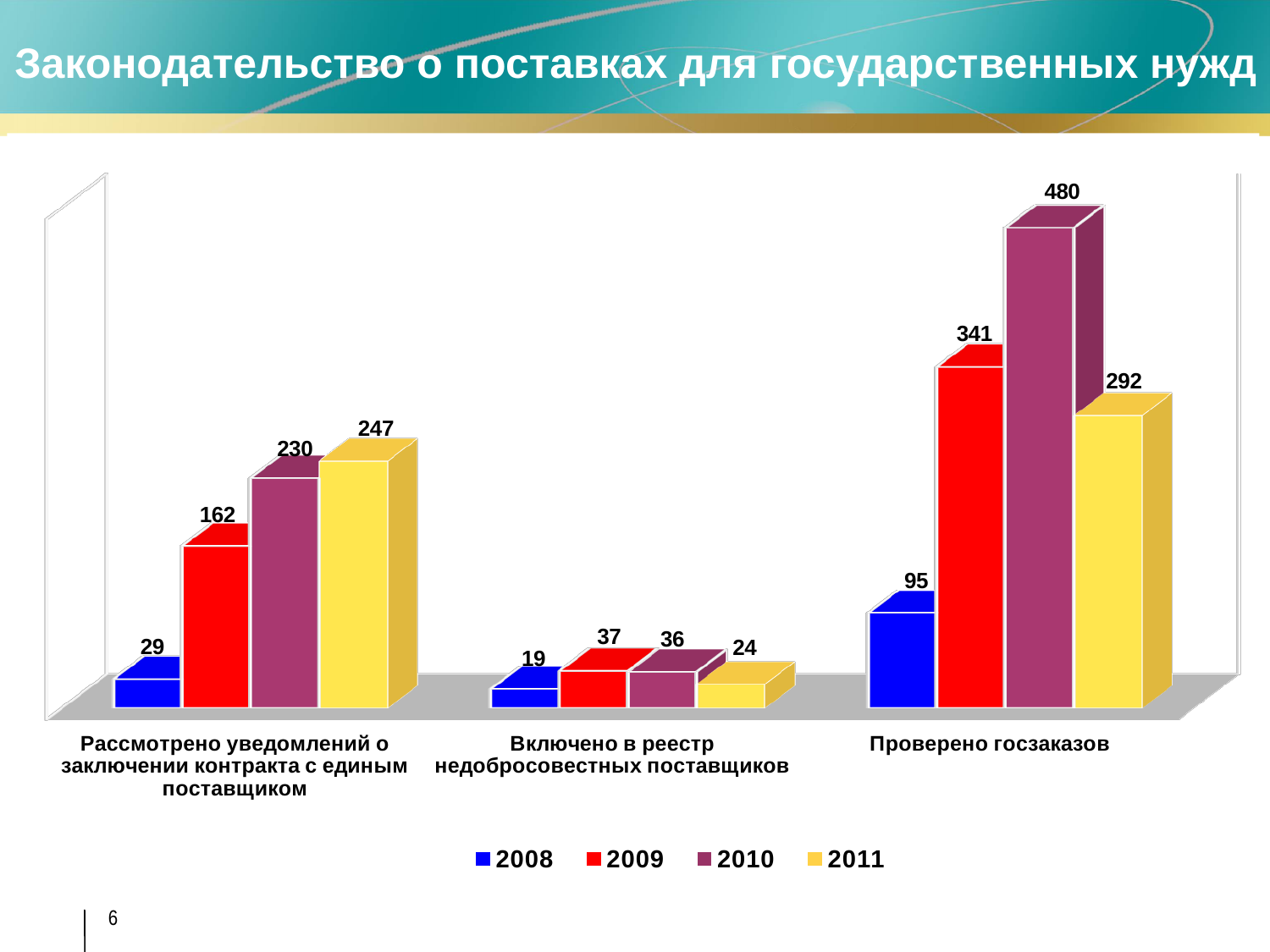
Which colour represents the 2011 series in the legend? yellow What is the value for 2008 in the category "Рассмотрено уведомлений о заключении контракта с единым поставщиком"? 29 Which year has the highest value in the category "Проверено госзаказов"? 2010 How many series does the legend list? 4 What is the value for 2011 in the category "Включено в реестр недобросовестных поставщиков"? 24 What kind of chart is shown on the slide? bar chart Which is larger: the 2009 value for "Проверено госзаказов" or the 2011 value for "Проверено госзаказов"? 2009 value for "Проверено госзаказов" What is the difference between the 2009 and 2008 values in the category "Рассмотрено уведомлений о заключении контракта с единым поставщиком"? 133 How many categories are shown on the x axis? 3 What is the difference between the 2010 and 2011 values in the category "Проверено госзаказов"? 188 Which year has the lowest value in the category "Рассмотрено уведомлений о заключении контракта с единым поставщиком"? 2008 What is the value for 2010 in the category "Проверено госзаказов"? 480